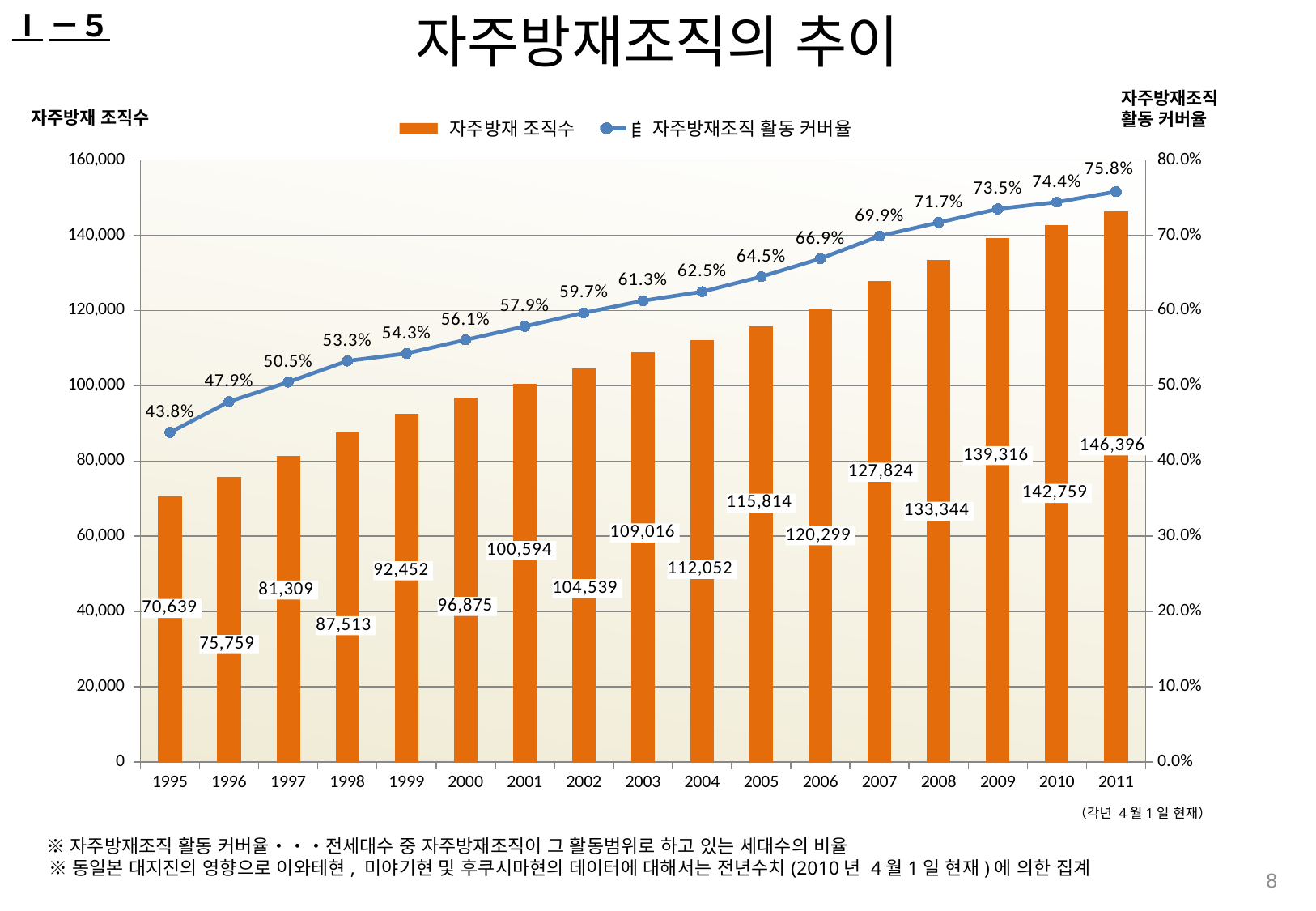
Which year has the lowest 자주방재조직 활동 커버율? 1995 By how many percentage points did the 자주방재조직 활동 커버율 increase from 1995 to 2011? 32.0 percentage points Which year has the highest 자주방재 조직수? 2011 Is the 자주방재 조직수 in 2001 greater or less than 100,000? greater What is the number of 자주방재 조직수 in 2003? 109,016 What is the 자주방재조직 활동 커버율 in 2007? 69.9% How many years are shown on the x axis of the chart? 17 How many series does the legend list? 2 Which year has a larger 자주방재 조직수, 2005 or 2008? 2008 What kind of chart is shown on the slide? A combined bar and line chart What is the difference in 자주방재 조직수 between 2011 and 1995? 75,757 What is the number of 자주방재 조직수 in 1998? 87,513